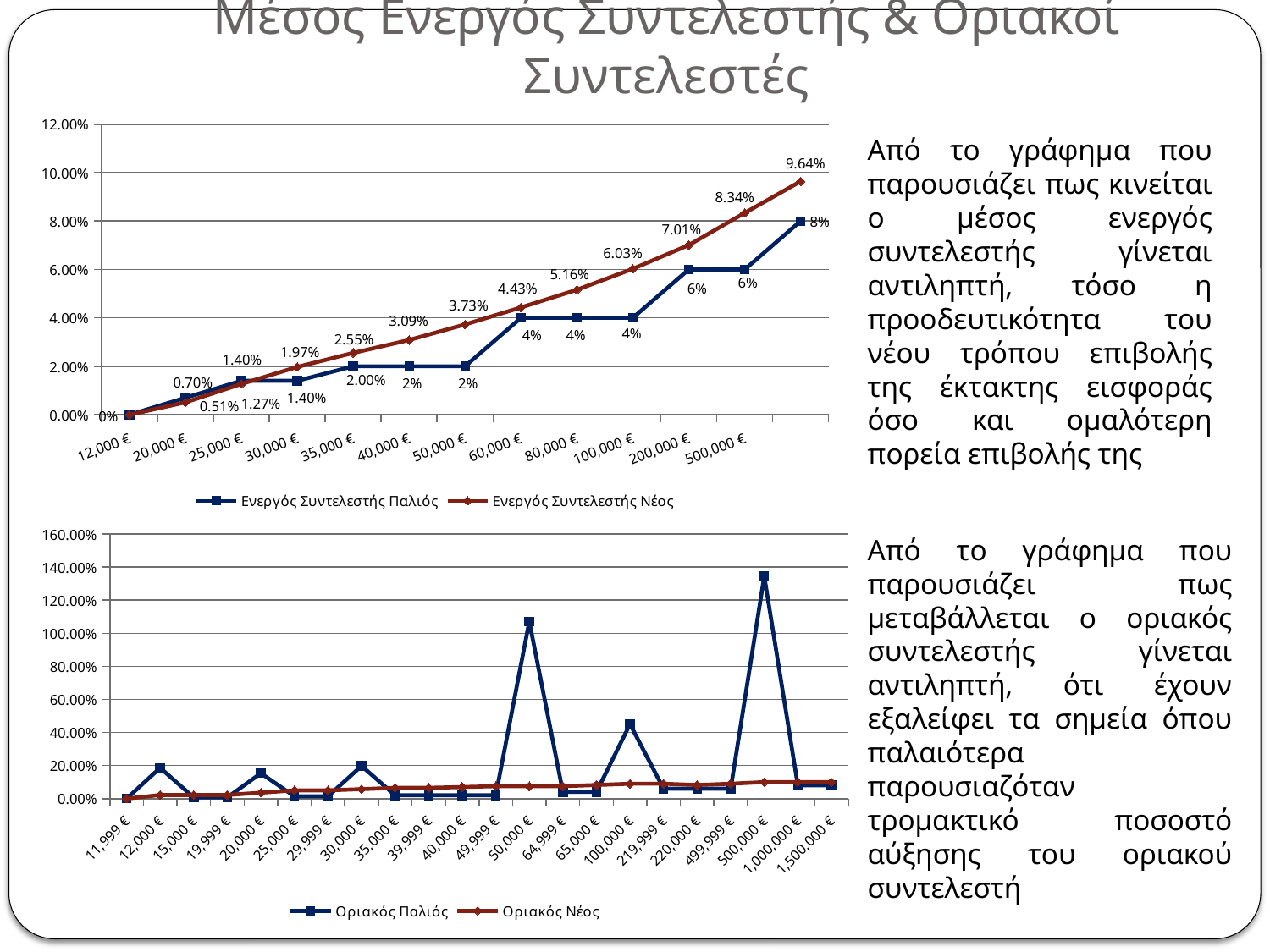
In the top chart, what is the value of Ενεργός Συντελεστής Παλιός at 20,000 €? 0.70% How many series does the legend of the top chart list? 2 What kind of chart is the top chart (Ενεργός Συντελεστής)? line chart In the top chart, what is the difference between the final labelled values of the two series (9.64% and 8%)? 1.64% In the bottom chart, at which category does the Οριακός Παλιός line reach its highest value? 500,000 € In the top chart, which series has the larger value at 20,000 €, Ενεργός Συντελεστής Παλιός or Ενεργός Συντελεστής Νέος? Ενεργός Συντελεστής Παλιός In the top chart, what is the highest value labelled on the Ενεργός Συντελεστής Παλιός line? 8% In the bottom chart, is the value of Οριακός Παλιός at 500,000 € greater or less than 120.00%? greater How many categories are shown on the x axis of the bottom chart (Οριακός)? 22 In the top chart, what is the value of Ενεργός Συντελεστής Νέος at 20,000 €? 0.51% In the top chart, does the Ενεργός Συντελεστής Νέος line rise or fall along the x axis? rises In the top chart, what is the highest value labelled on the Ενεργός Συντελεστής Νέος line? 9.64%